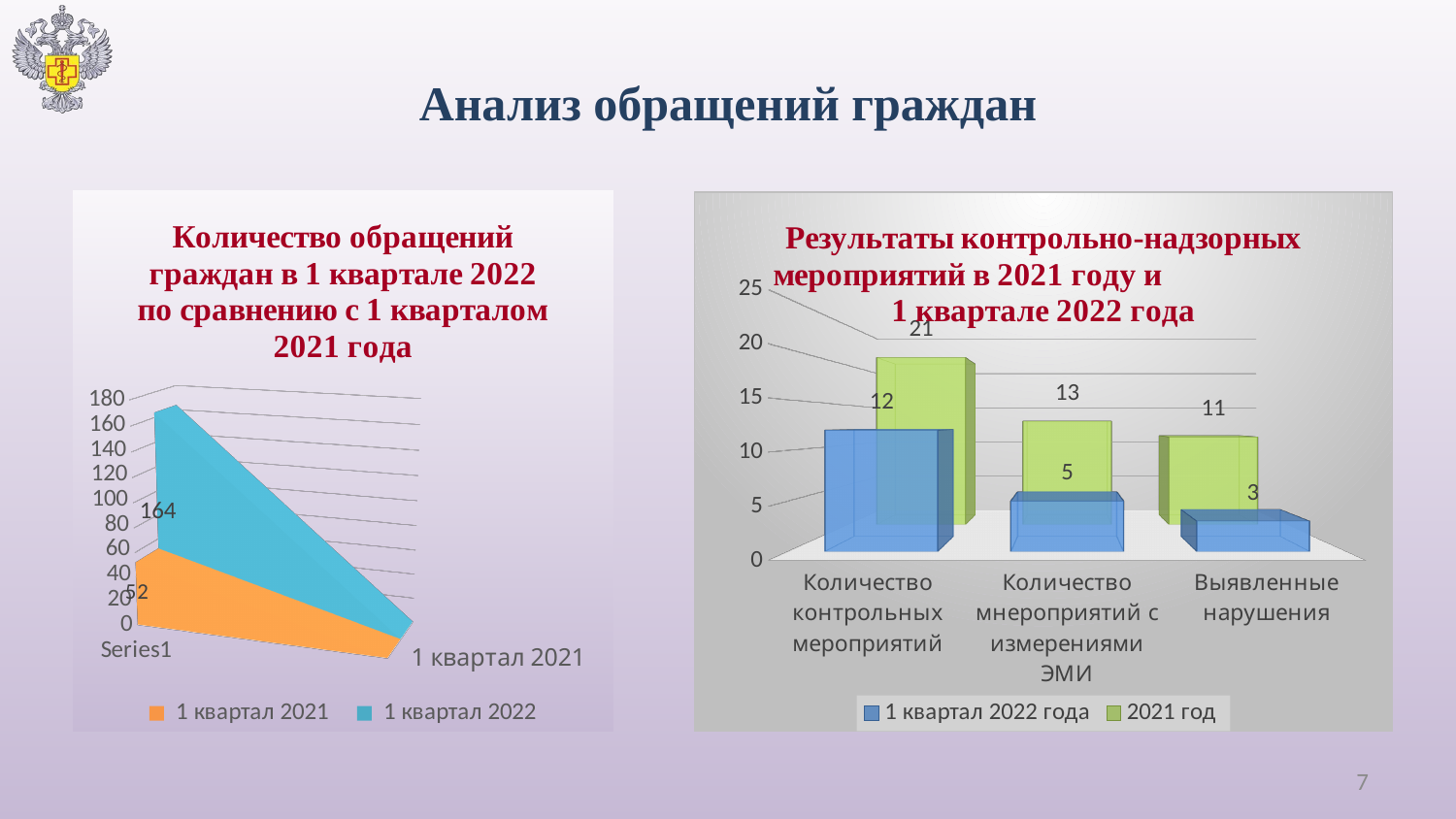
In the right chart (Результаты контрольно-надзорных мероприятий), what is the difference between the 2021 год and 1 квартал 2022 года values for Выявленные нарушения? 8 In the right chart (Результаты контрольно-надзорных мероприятий), what is the 2021 год value for Количество контрольных мероприятий? 21 In the right chart (Результаты контрольно-надзорных мероприятий), what is the 2021 год value for Количество мнероприятий с измерениями ЭМИ? 13 What kind of chart is the right chart (Результаты контрольно-надзорных мероприятий)? Bar chart In the right chart (Результаты контрольно-надзорных мероприятий), which category has the lowest 1 квартал 2022 года value? Выявленные нарушения In the left chart (Количество обращений граждан), what is the value for 1 квартал 2022? 164 In the right chart (Результаты контрольно-надзорных мероприятий), which category has the highest 2021 год value? Количество контрольных мероприятий In the right chart (Результаты контрольно-надзорных мероприятий), what is the 1 квартал 2022 года value for Выявленные нарушения? 3 In the left chart (Количество обращений граждан), what is the difference between the 1 квартал 2022 value and the 1 квартал 2021 value? 112 In the left chart (Количество обращений граждан), how many series does the legend list? 2 In the right chart (Результаты контрольно-надзорных мероприятий), how many categories are shown on the x axis? 3 In the left chart (Количество обращений граждан), what is the value for 1 квартал 2021? 52